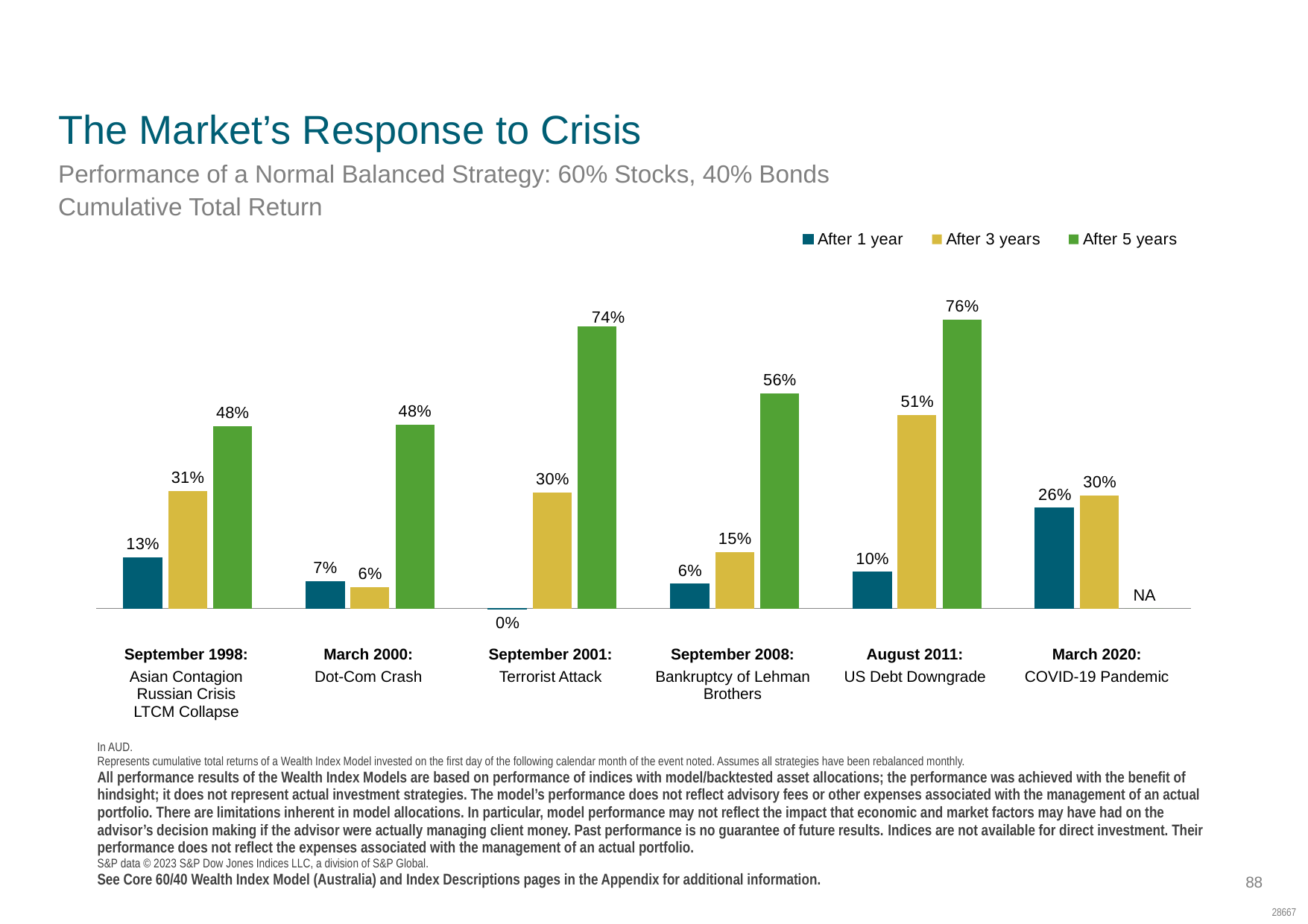
Which is larger: the After 3 years return for March 2000 Dot-Com Crash or the After 3 years return for September 1998? September 1998 What value is shown for the After 5 years return for the March 2020 COVID-19 Pandemic? NA What kind of chart is shown on the slide? Bar chart What is the difference between the After 5 years and After 3 years returns for the September 2008 Bankruptcy of Lehman Brothers? 41% How many crisis events are shown on the x axis? 6 Which crisis has the lowest After 1 year return? September 2001: Terrorist Attack Which crisis has the highest After 5 years return? August 2011: US Debt Downgrade What is the cumulative total return after 1 year for the September 2001 Terrorist Attack? 0% What is the cumulative total return after 1 year for the March 2020 COVID-19 Pandemic? 26% What is the cumulative total return after 3 years for the August 2011 US Debt Downgrade? 51% How many series does the legend list? 3 What is the cumulative total return after 5 years for the September 2001 Terrorist Attack? 74%